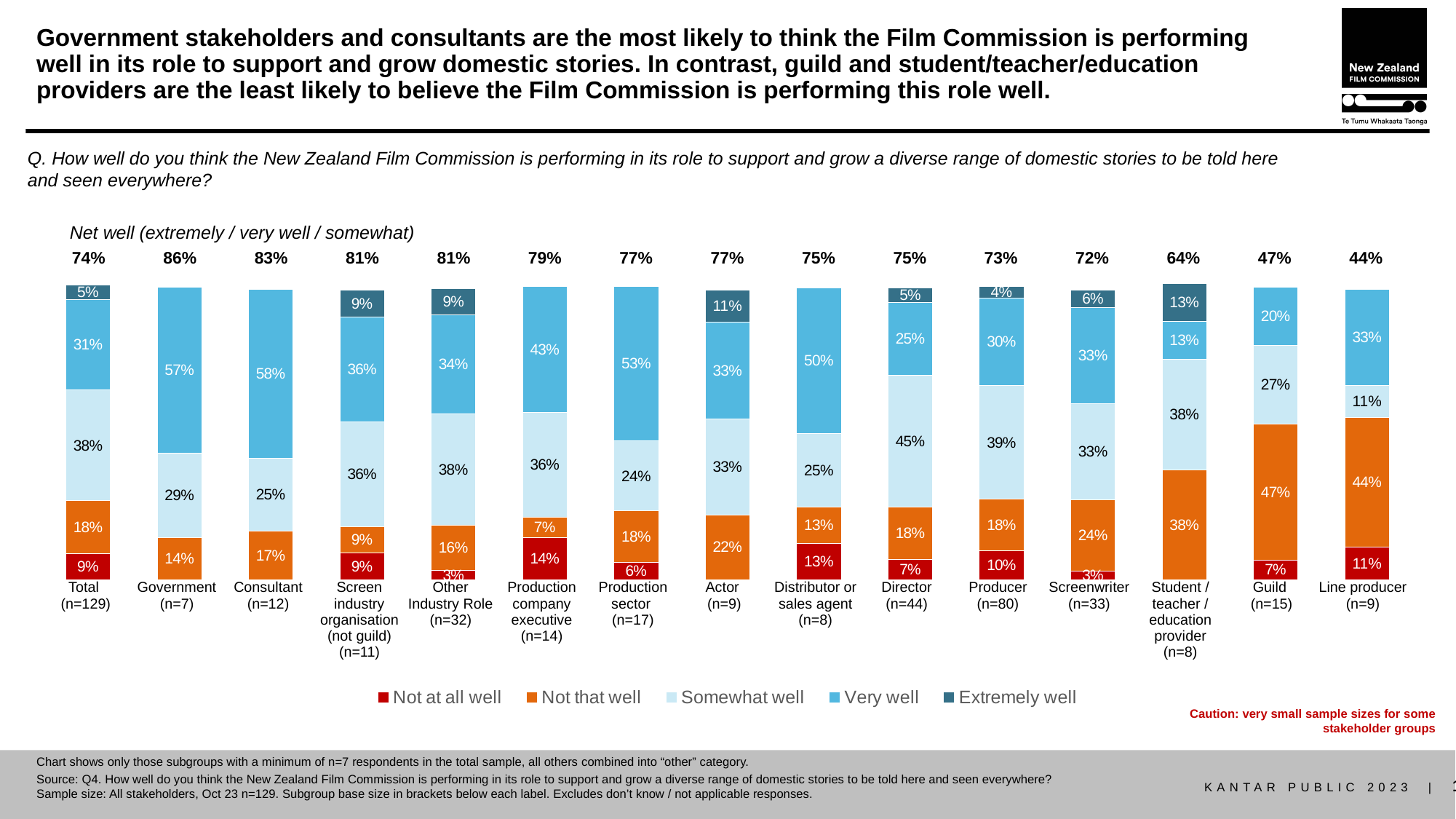
What kind of chart is shown on the slide? Stacked bar chart How many stakeholder groups (bars) are shown on the chart? 15 What is the difference between the Net well percentages for Consultant and Screenwriter? 11% How many series does the legend list? 5 What percentage of Guild respondents said 'Not that well'? 47% What is the 'Somewhat well' percentage for Director (n=44)? 45% What percentage of Production sector respondents said 'Very well'? 53% What is the Net well percentage for Government (n=7)? 86% What is the 'Extremely well' percentage for Student / teacher / education provider (n=8)? 13% Which stakeholder group has the lowest Net well percentage? Line producer (n=9) Which stakeholder group has the highest Net well percentage? Government (n=7) Which is larger: the 'Not at all well' share for Actor or for Line producer? Line producer